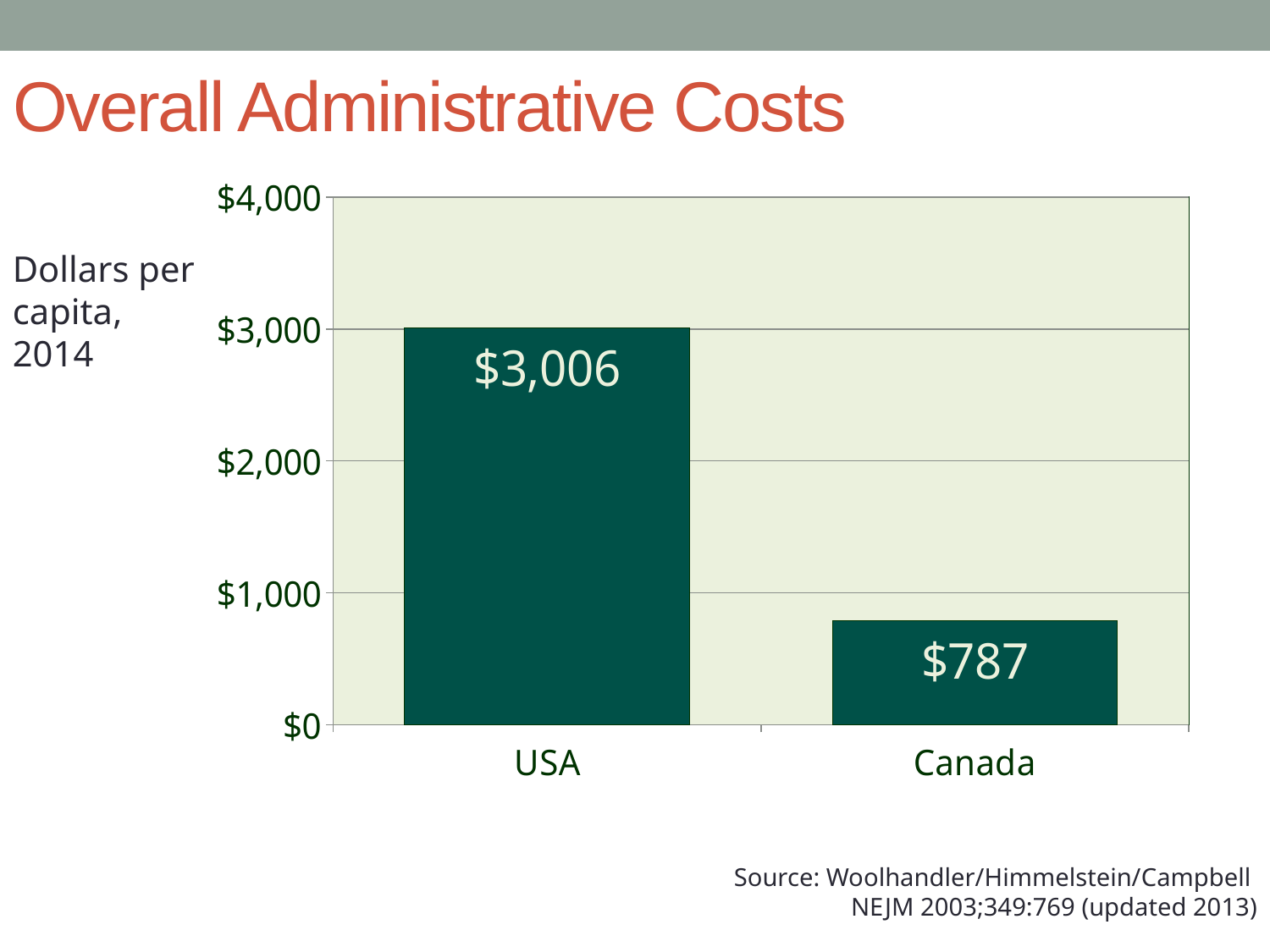
Which category has the lowest value? Canada What is the value for USA? $3,006 What is the title of the slide? Overall Administrative Costs What kind of chart is shown on the slide? bar chart Which is larger, the value for USA or the value for Canada? USA What is the difference between the values for USA and Canada? $2,219 What is the value for Canada? $787 Is the value for Canada greater or less than $1,000? less How many categories are shown in the chart? 2 What unit is the vertical axis measured in, according to the label on the left? Dollars per capita, 2014 Which category has the highest value? USA Is the value for USA greater or less than $3,000? greater